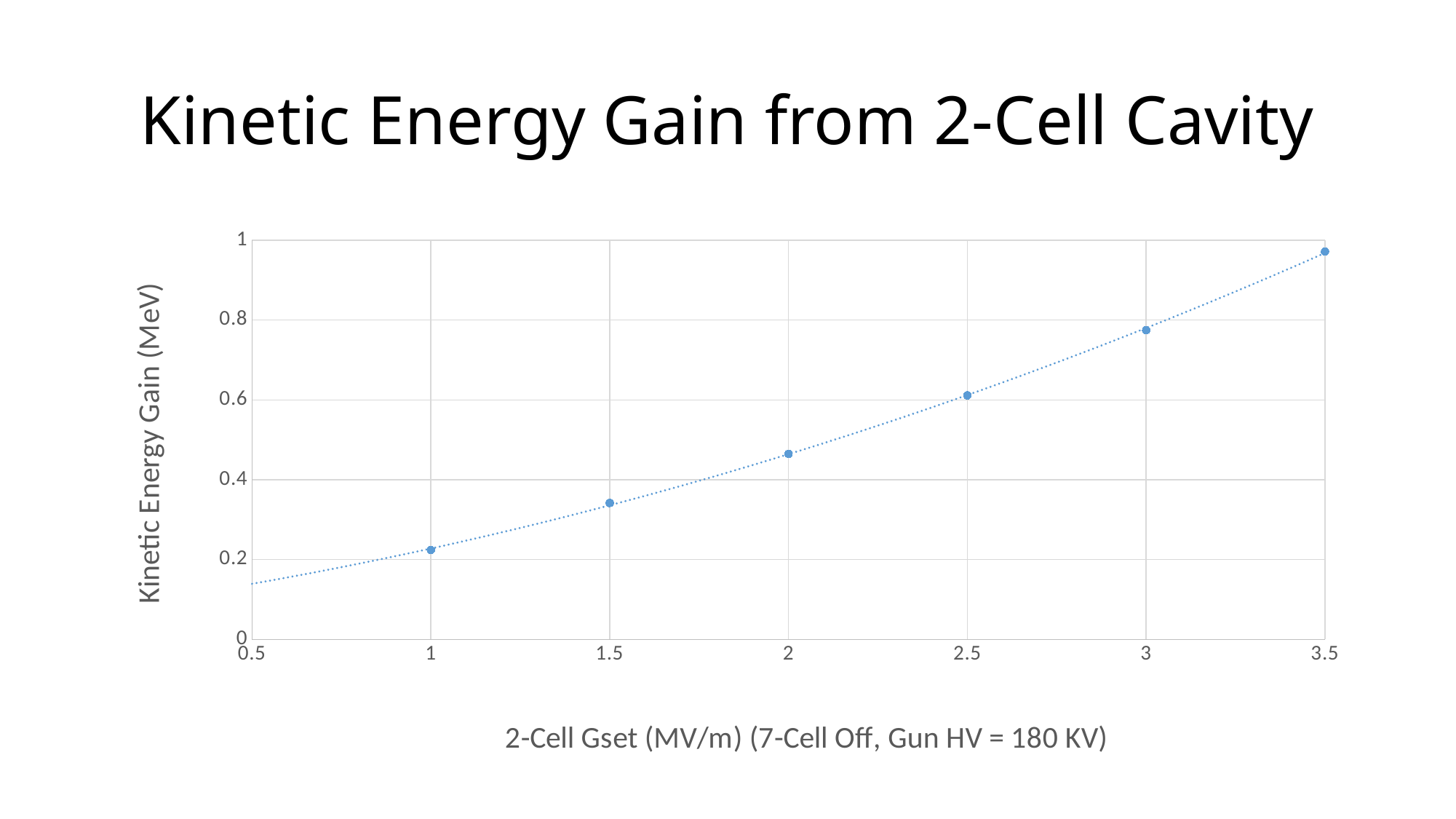
Is the kinetic energy gain at a 2-Cell Gset of 3 greater or less than 0.6 MeV? greater Is the kinetic energy gain at a 2-Cell Gset of 1 greater or less than 0.4 MeV? less At which 2-Cell Gset value is the kinetic energy gain highest? 3.5 How many data points are plotted on the chart? 6 What kind of chart is shown on the slide? scatter chart What is the title of the chart? Kinetic Energy Gain from 2-Cell Cavity Does the kinetic energy gain rise or fall as the 2-Cell Gset increases? rise At which 2-Cell Gset value is the kinetic energy gain lowest? 1 What is the label of the vertical axis? Kinetic Energy Gain (MeV) Which has the larger kinetic energy gain: a 2-Cell Gset of 1.5 or 2.5? 2.5 Is the kinetic energy gain at a 2-Cell Gset of 2 greater or less than 0.4 MeV? greater